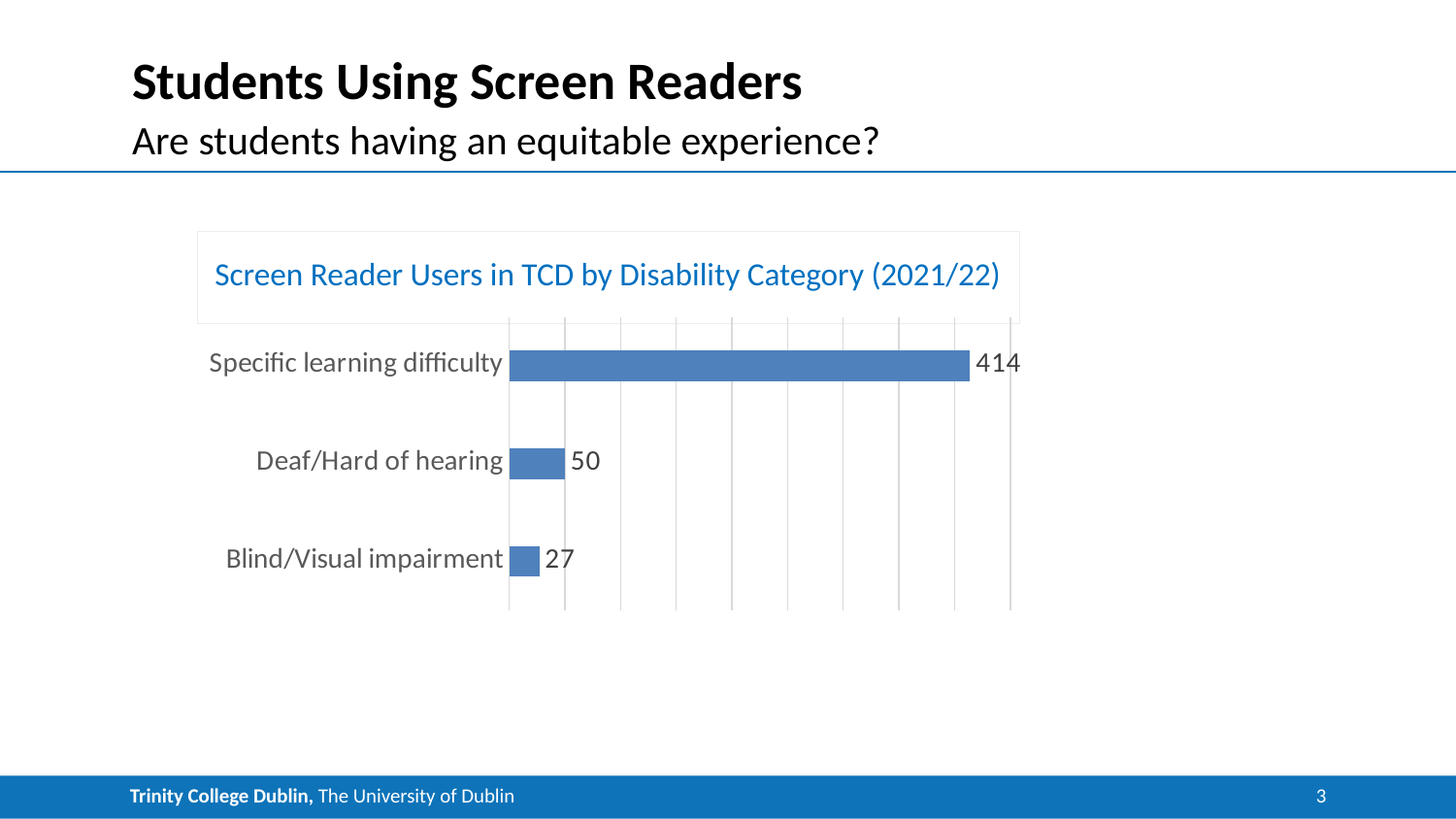
Which is larger, the value for Deaf/Hard of hearing or the value for Blind/Visual impairment? Deaf/Hard of hearing How many disability categories are shown in the chart? 3 What is the value for Deaf/Hard of hearing? 50 What is the difference between the values for Deaf/Hard of hearing and Blind/Visual impairment? 23 What is the title of the chart? Screen Reader Users in TCD by Disability Category (2021/22) What colour are the bars in the chart? Blue Which disability category has the highest number of screen reader users? Specific learning difficulty What is the difference between the values for Specific learning difficulty and Deaf/Hard of hearing? 364 Which disability category has the lowest number of screen reader users? Blind/Visual impairment What is the value for Blind/Visual impairment? 27 What is the value for Specific learning difficulty? 414 What kind of chart is shown on the slide? Bar chart